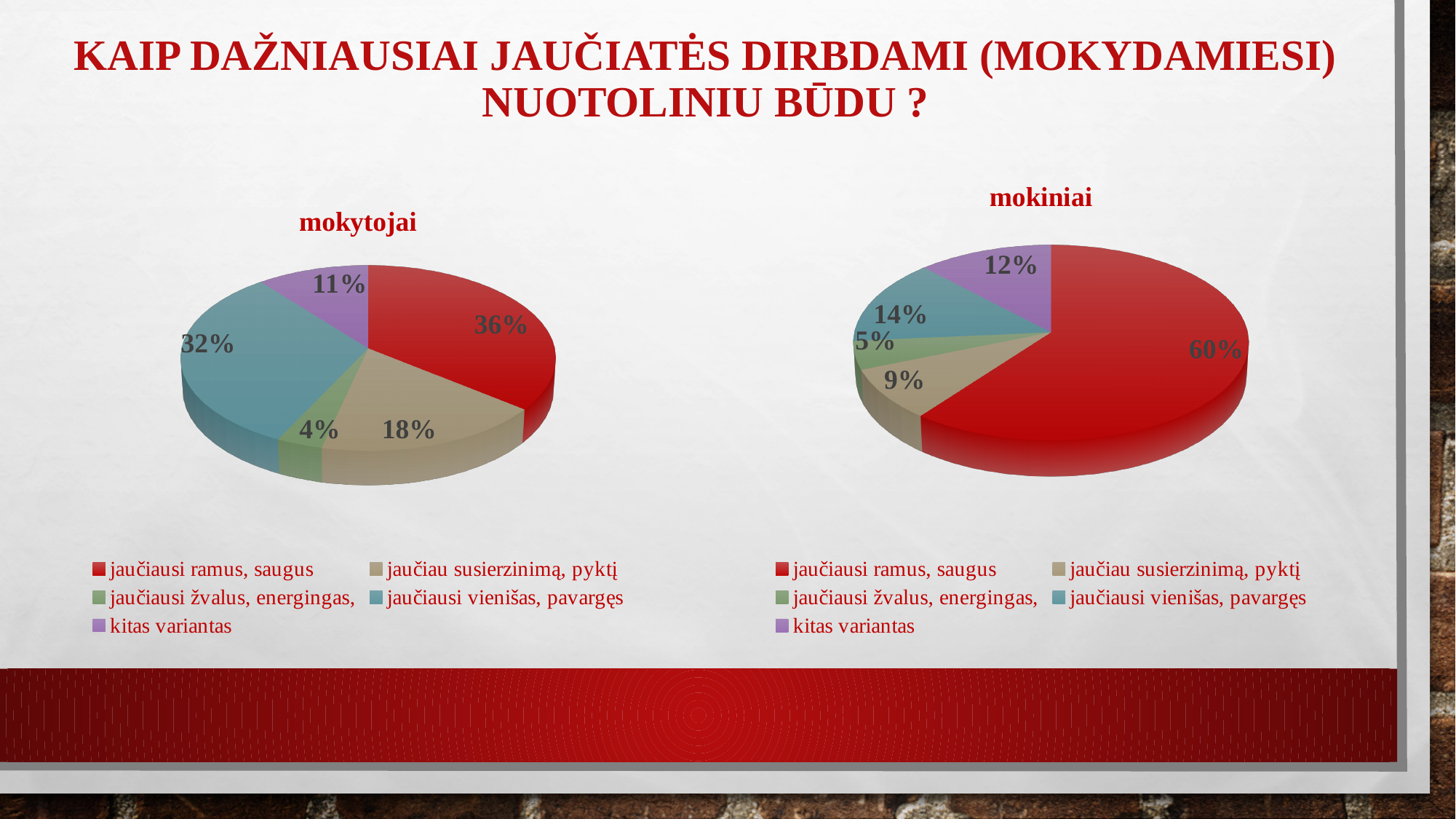
In the "mokiniai" pie chart, what percentage is shown for "kitas variantas"? 12% In the "mokytojai" pie chart, which category has the smallest slice? jaučiausi žvalus, energingas How many slices does the "mokiniai" pie chart have? 5 In the "mokiniai" pie chart, what percentage is shown for "jaučiausi ramus, saugus"? 60% In the "mokytojai" pie chart, what percentage is shown for "jaučiausi vienišas, pavargęs"? 32% In the "mokiniai" pie chart, which category has the largest slice? jaučiausi ramus, saugus What type of chart is used for "mokytojai"? Pie chart In the "mokytojai" pie chart, what percentage is shown for "jaučiausi ramus, saugus"? 36% In the "mokytojai" pie chart, which is larger: "jaučiau susierzinimą, pyktį" or "kitas variantas"? jaučiau susierzinimą, pyktį Which colour represents "jaučiausi vienišas, pavargęs" in the legends? Teal In the "mokiniai" pie chart, what percentage is shown for "jaučiau susierzinimą, pyktį"? 9% What is the difference between the "jaučiausi ramus, saugus" share in the "mokiniai" chart and in the "mokytojai" chart? 24%